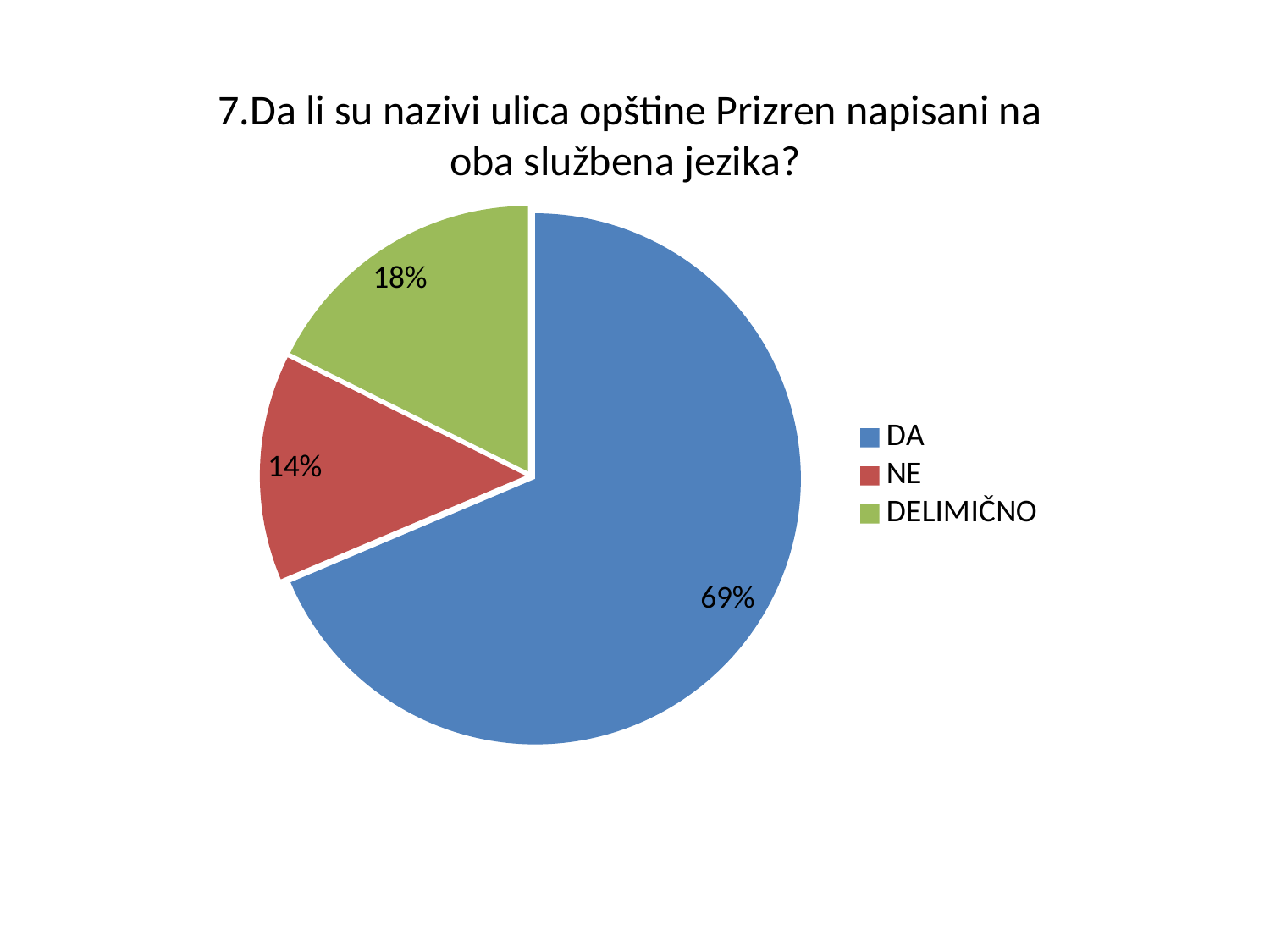
What is the title of the chart? 7.Da li su nazivi ulica opštine Prizren napisani na oba službena jezika? What percentage of responses are 'DELIMIČNO'? 18% What colour is the 'DELIMIČNO' slice? green What is the difference in percentage points between 'DELIMIČNO' and 'NE'? 4 What type of chart is shown on the slide? pie chart What is the difference in percentage points between 'DA' and 'DELIMIČNO'? 51 Which category has the largest share of the pie? DA What percentage of responses are 'DA'? 69% How many categories does the legend list? 3 Which is larger, the share for 'NE' or the share for 'DELIMIČNO'? DELIMIČNO Which category has the smallest share of the pie? NE What percentage of responses are 'NE'? 14%